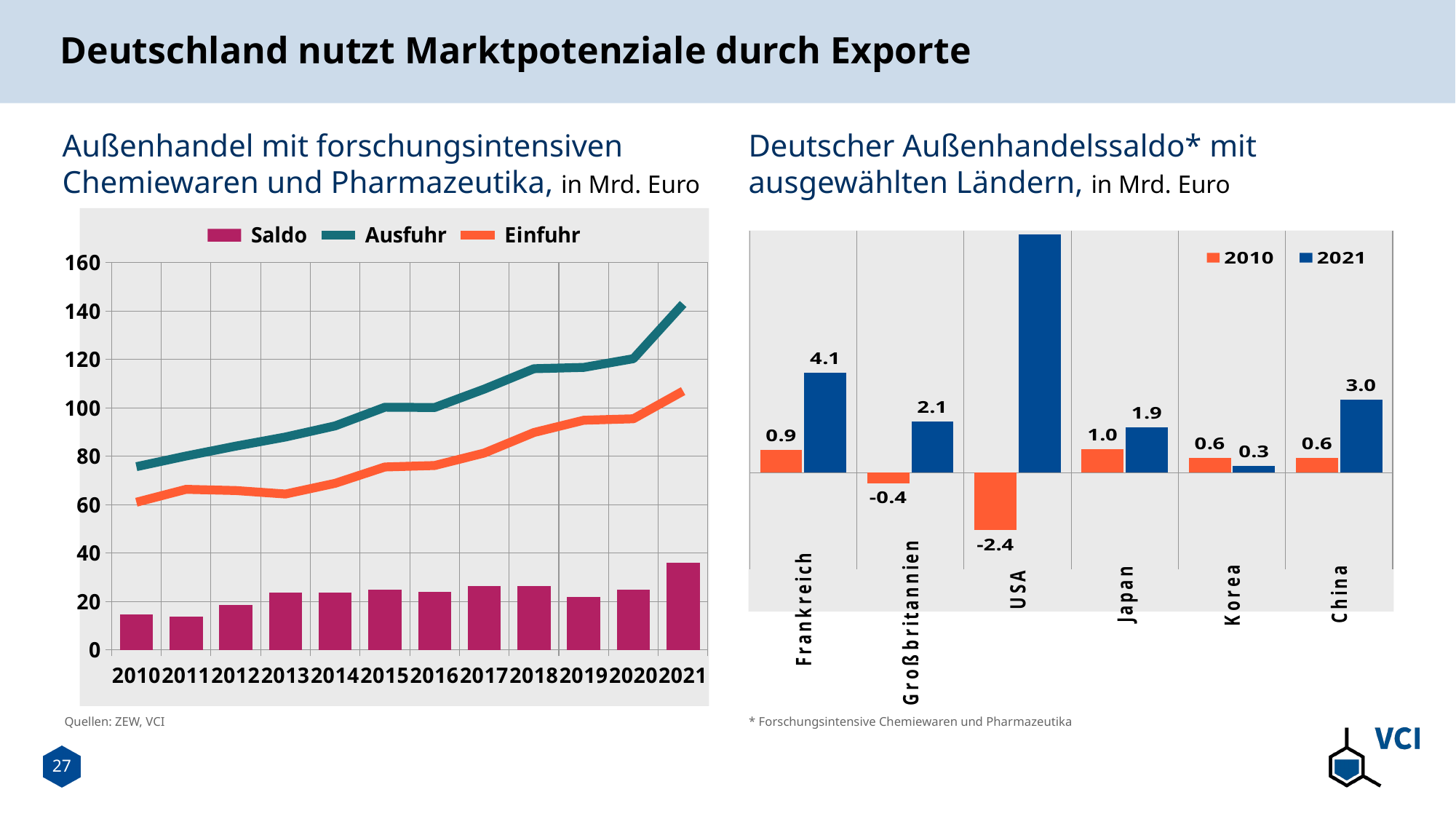
In the chart 'Deutscher Außenhandelssaldo mit ausgewählten Ländern', which is larger in 2021: Japan or China? China In the chart 'Deutscher Außenhandelssaldo mit ausgewählten Ländern', what is the value for Korea in 2021? 0.3 How many countries are shown in the chart 'Deutscher Außenhandelssaldo mit ausgewählten Ländern'? 6 How many series does the legend of the chart 'Außenhandel mit forschungsintensiven Chemiewaren und Pharmazeutika' list? 3 In the chart 'Deutscher Außenhandelssaldo mit ausgewählten Ländern', what is the difference between the 2021 and 2010 values for Frankreich? 3.2 In the chart 'Deutscher Außenhandelssaldo mit ausgewählten Ländern', what is the value for Frankreich in 2021? 4.1 In the chart 'Außenhandel mit forschungsintensiven Chemiewaren und Pharmazeutika', does the Ausfuhr line rise or fall from 2010 to 2021? rise In the chart 'Außenhandel mit forschungsintensiven Chemiewaren und Pharmazeutika', is the Einfuhr value for 2021 greater or less than 100? greater In the chart 'Deutscher Außenhandelssaldo mit ausgewählten Ländern', what is the value for USA in 2010? -2.4 In the chart 'Deutscher Außenhandelssaldo mit ausgewählten Ländern', which country has the lowest value in 2010? USA In the chart 'Außenhandel mit forschungsintensiven Chemiewaren und Pharmazeutika', which year has the highest Saldo bar? 2021 In the chart 'Deutscher Außenhandelssaldo mit ausgewählten Ländern', which country has the highest value in 2021? USA